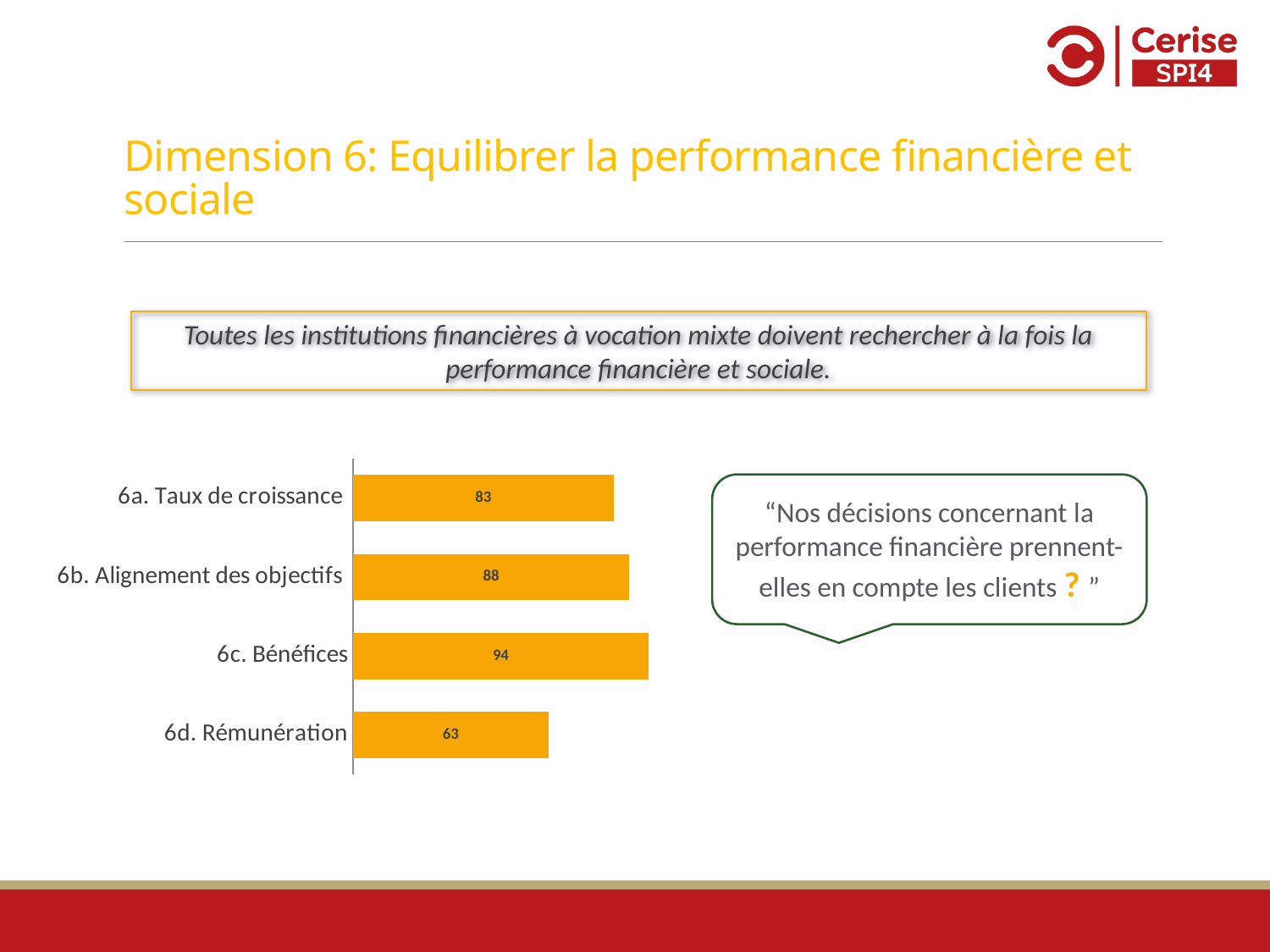
How many categories are shown in the chart? 4 What is the value for 6b. Alignement des objectifs? 88 What is the value for 6a. Taux de croissance? 83 What is the value for 6c. Bénéfices? 94 What colour are the bars in the chart? orange What is the value for 6d. Rémunération? 63 What kind of chart is shown on the slide? bar chart What is the difference between the values for 6b. Alignement des objectifs and 6a. Taux de croissance? 5 What is the difference between the values for 6c. Bénéfices and 6d. Rémunération? 31 Which category has the lowest value? 6d. Rémunération Which category has the highest value? 6c. Bénéfices Which is larger, the value for 6a. Taux de croissance or the value for 6b. Alignement des objectifs? 6b. Alignement des objectifs